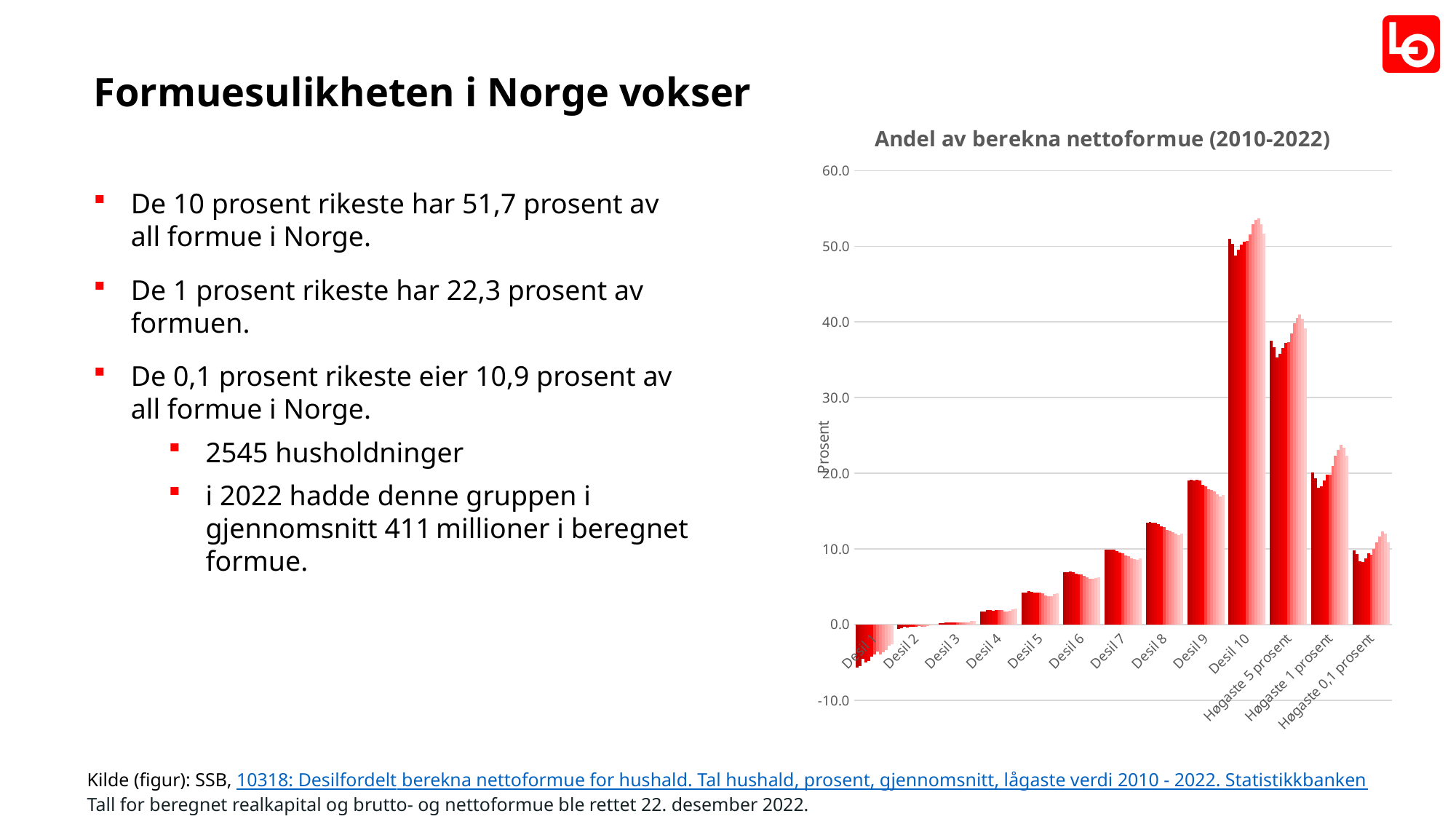
What is the label on the vertical axis of the chart? Prosent Are the values for Desil 5 greater or less than 10.0? less Which category has the lowest values in the chart? Desil 1 Are the values for Desil 1 greater or less than 0.0? less Which category has the highest values in the chart? Desil 10 Are the values for Desil 10 greater or less than 40.0? greater Do the values rise or fall from Desil 1 to Desil 10? rise Which category has larger values, Desil 10 or Høgaste 5 prosent? Desil 10 What kind of chart is shown on the slide? bar chart What is the title of the chart? Andel av berekna nettoformue (2010-2022) How many categories are shown along the x axis of the chart? 13